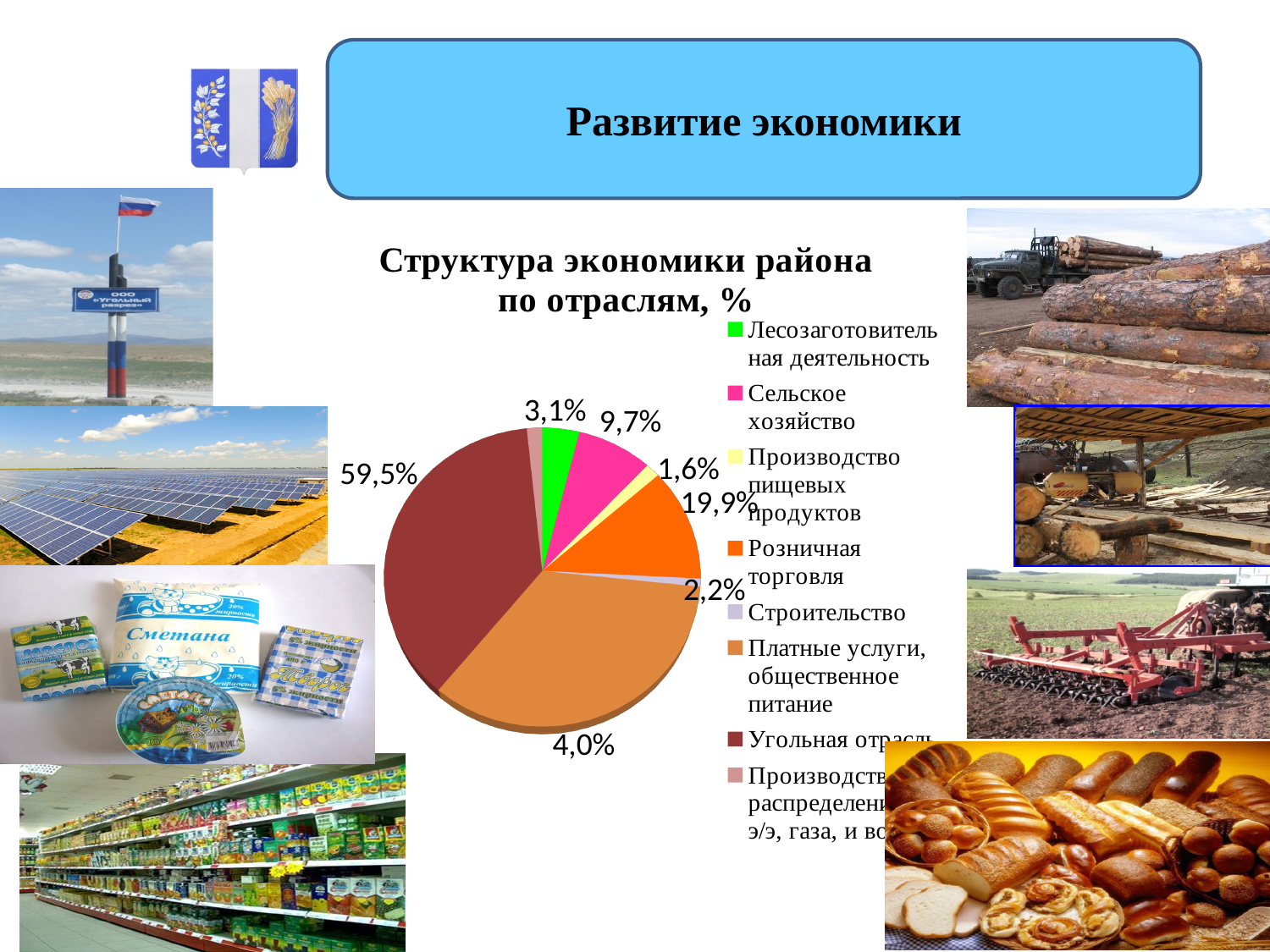
What share of the district economy is Сельское хозяйство? 9,7% By how many percentage points does Розничная торговля exceed Сельское хозяйство? 10,2 Which colour represents Лесозаготовительная деятельность in the chart? green What kind of chart is shown on the slide? pie chart What share of the district economy is Лесозаготовительная деятельность? 3,1% What share of the district economy is Строительство? 2,2% How many categories does the chart legend list? 8 What is the title of the chart? Структура экономики района по отраслям, % What share of the district economy is Производство пищевых продуктов? 1,6% What share of the district economy is Розничная торговля? 19,9% Which is larger, the share of Сельское хозяйство or the share of Лесозаготовительная деятельность? Сельское хозяйство Which is larger, the share of Розничная торговля or the share of Строительство? Розничная торговля